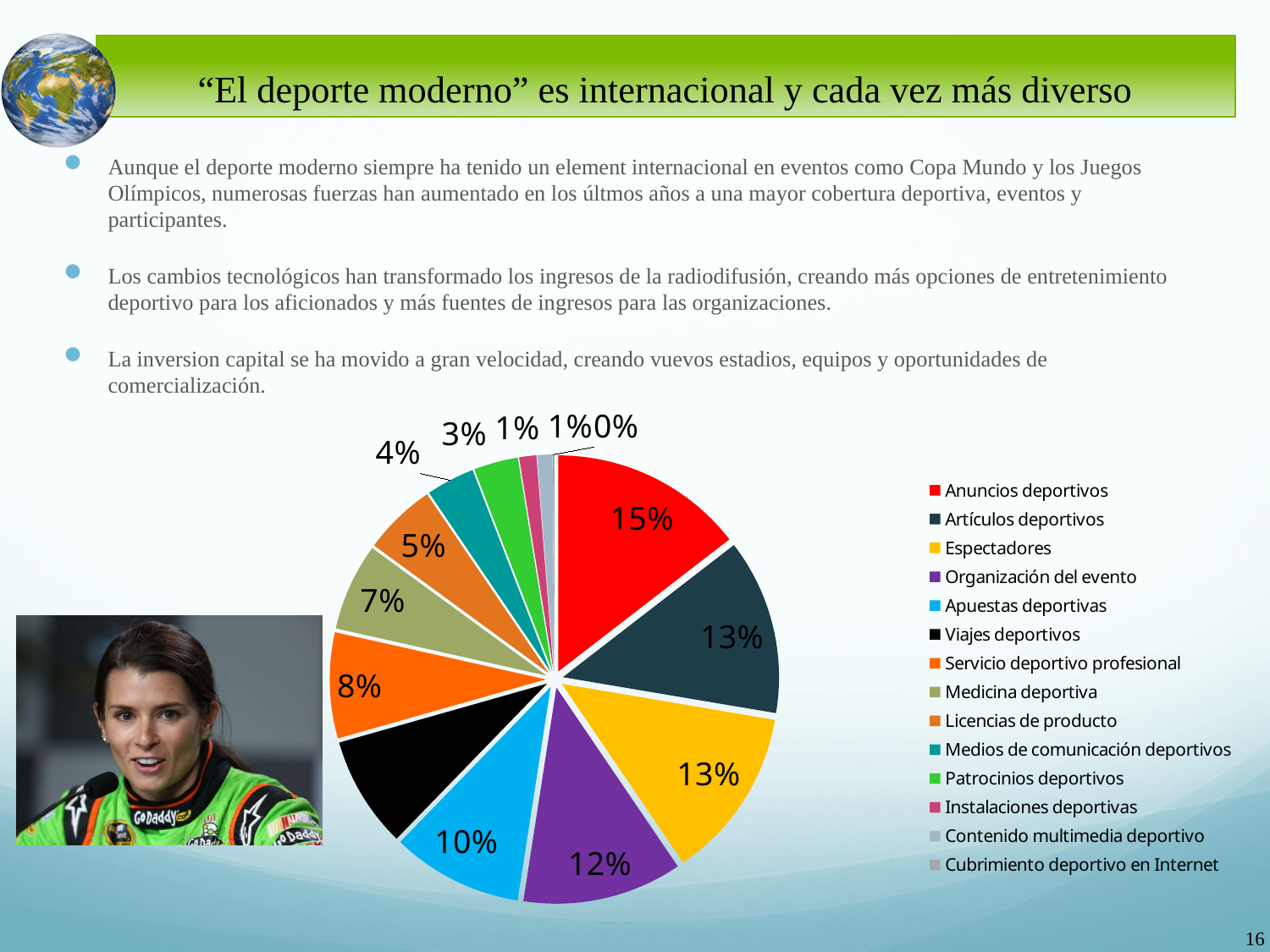
What percentage of the pie does Medicina deportiva represent? 7% What percentage of the pie does Organización del evento represent? 12% Which category has the largest share of the pie? Anuncios deportivos What colour is the Anuncios deportivos slice in the pie chart? red What percentage of the pie does Apuestas deportivas represent? 10% How many categories does the legend of the pie chart list? 14 Which category has the smallest share of the pie? Cubrimiento deportivo en Internet What percentage of the pie does Anuncios deportivos represent? 15% What kind of chart is shown on the slide? pie chart What is the difference in percentage points between Anuncios deportivos and Organización del evento? 3 Which has a larger share of the pie, Apuestas deportivas or Medicina deportiva? Apuestas deportivas What percentage of the pie does Licencias de producto represent? 5%